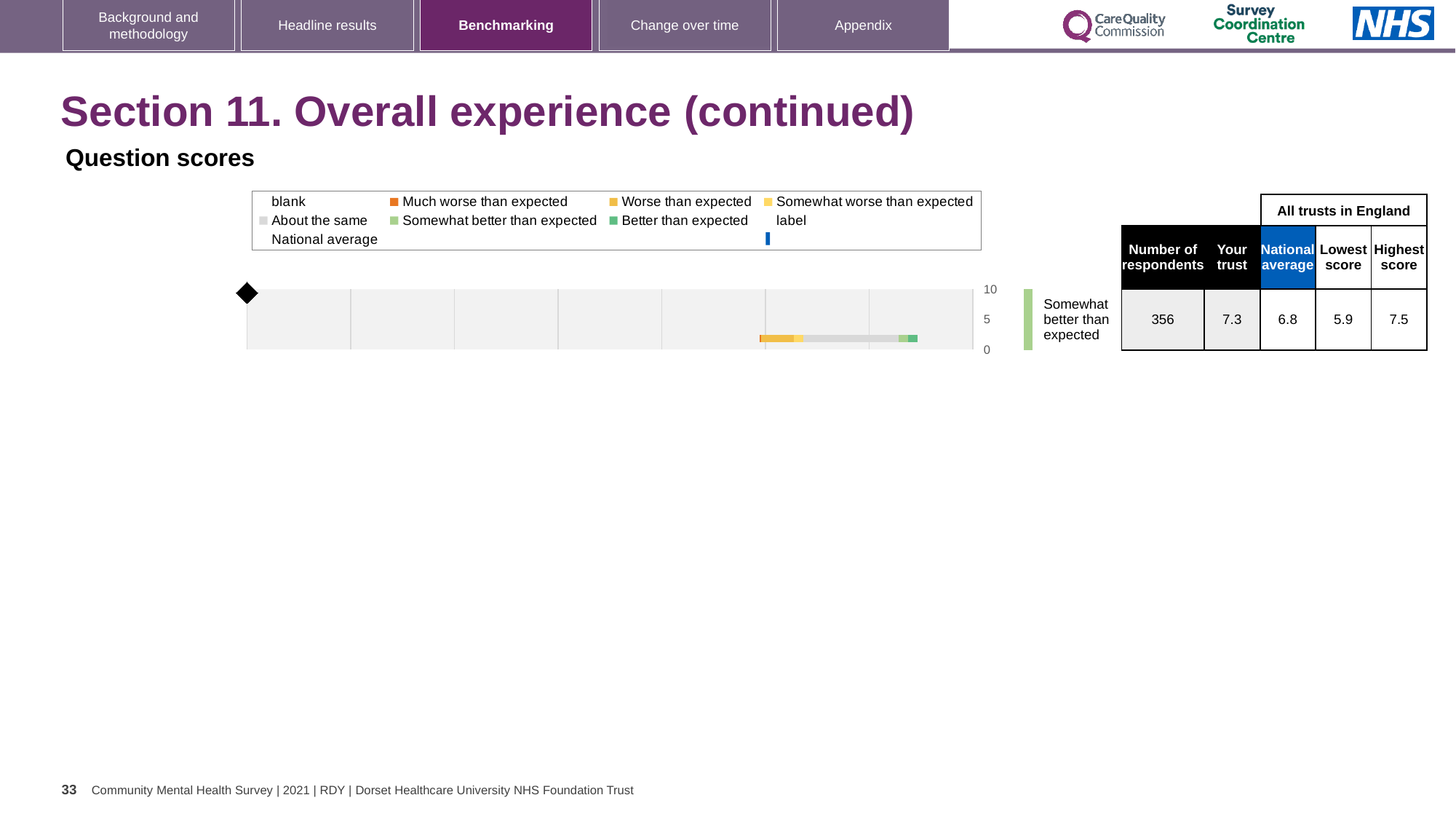
What is the category label shown next to the plotted bar? Somewhat better than expected What is the difference between the highest score and the lowest score for the plotted question? 1.6 What is the highest score among all trusts in England for the plotted question? 7.5 How many bars are plotted in the chart? 1 How many entries does the chart legend list? 9 Which is larger for the plotted question, the 'Your trust' score or the national average? Your trust What kind of chart is shown under 'Question scores'? bar chart What is the national average score shown for the plotted question? 6.8 What is the difference between the 'Your trust' score and the national average for the plotted question? 0.5 What is the lowest score among all trusts in England for the plotted question? 5.9 How many respondents are shown for the plotted question? 356 What is the 'Your trust' score shown for the plotted question? 7.3